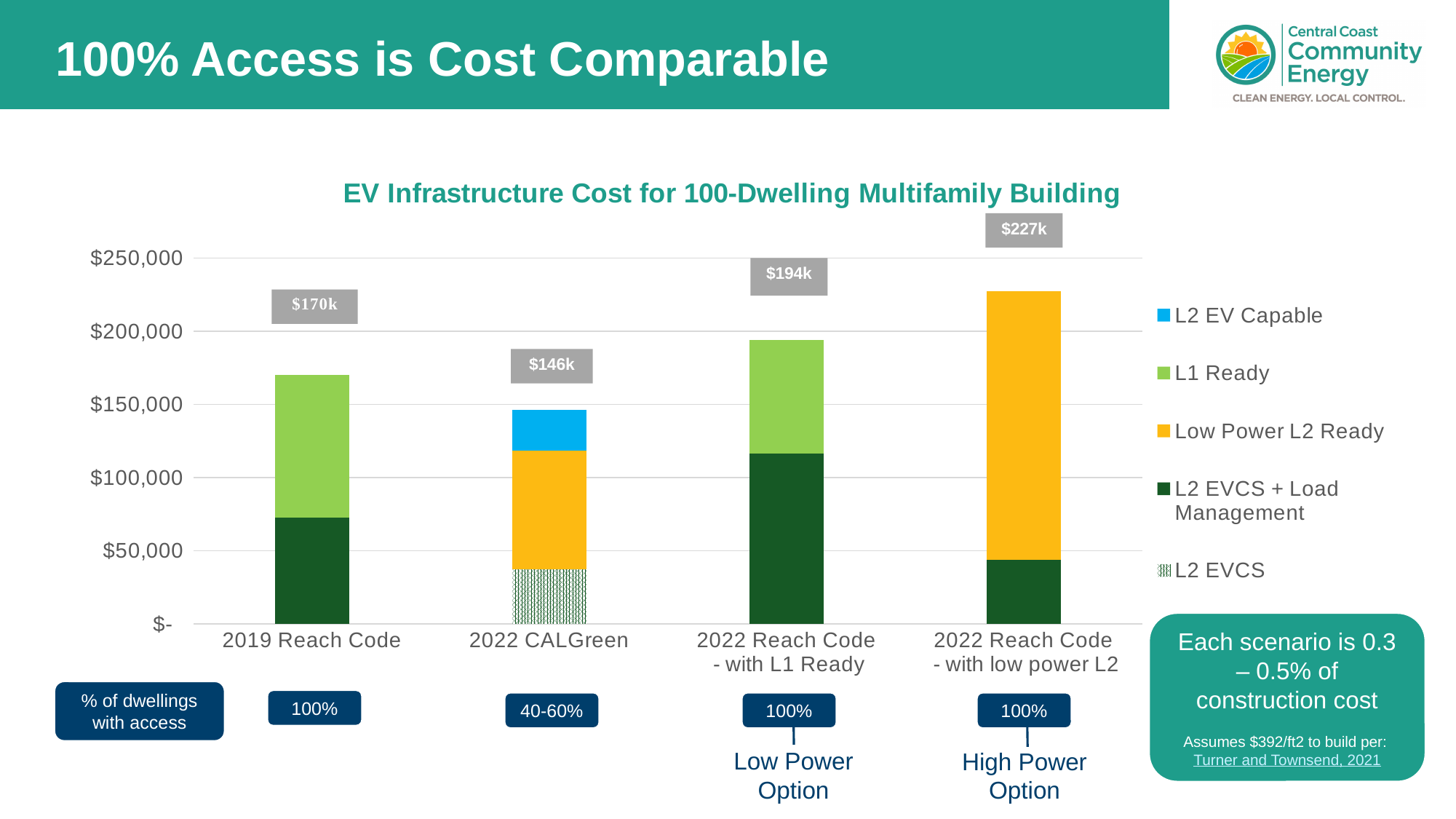
Which scenario has the lowest total EV infrastructure cost? 2022 CALGreen What is the difference between the total cost of the 2022 Reach Code - with low power L2 scenario and the 2019 Reach Code scenario? $57k How many series does the legend list? 5 What is the total EV infrastructure cost shown for the 2019 Reach Code scenario? $170k What is the total cost shown for the 2022 Reach Code - with L1 Ready scenario? $194k Which has a higher total cost: 2022 CALGreen or 2022 Reach Code - with L1 Ready? 2022 Reach Code - with L1 Ready What is the title of the chart? EV Infrastructure Cost for 100-Dwelling Multifamily Building Which scenario has the highest total EV infrastructure cost? 2022 Reach Code - with low power L2 Is the L2 EVCS + Load Management segment for the 2019 Reach Code bar greater or less than $50,000? greater What kind of chart is shown on the slide? Stacked bar chart What is the total cost label shown above the 2022 CALGreen bar? $146k How many scenarios (bars) are shown on the chart? 4